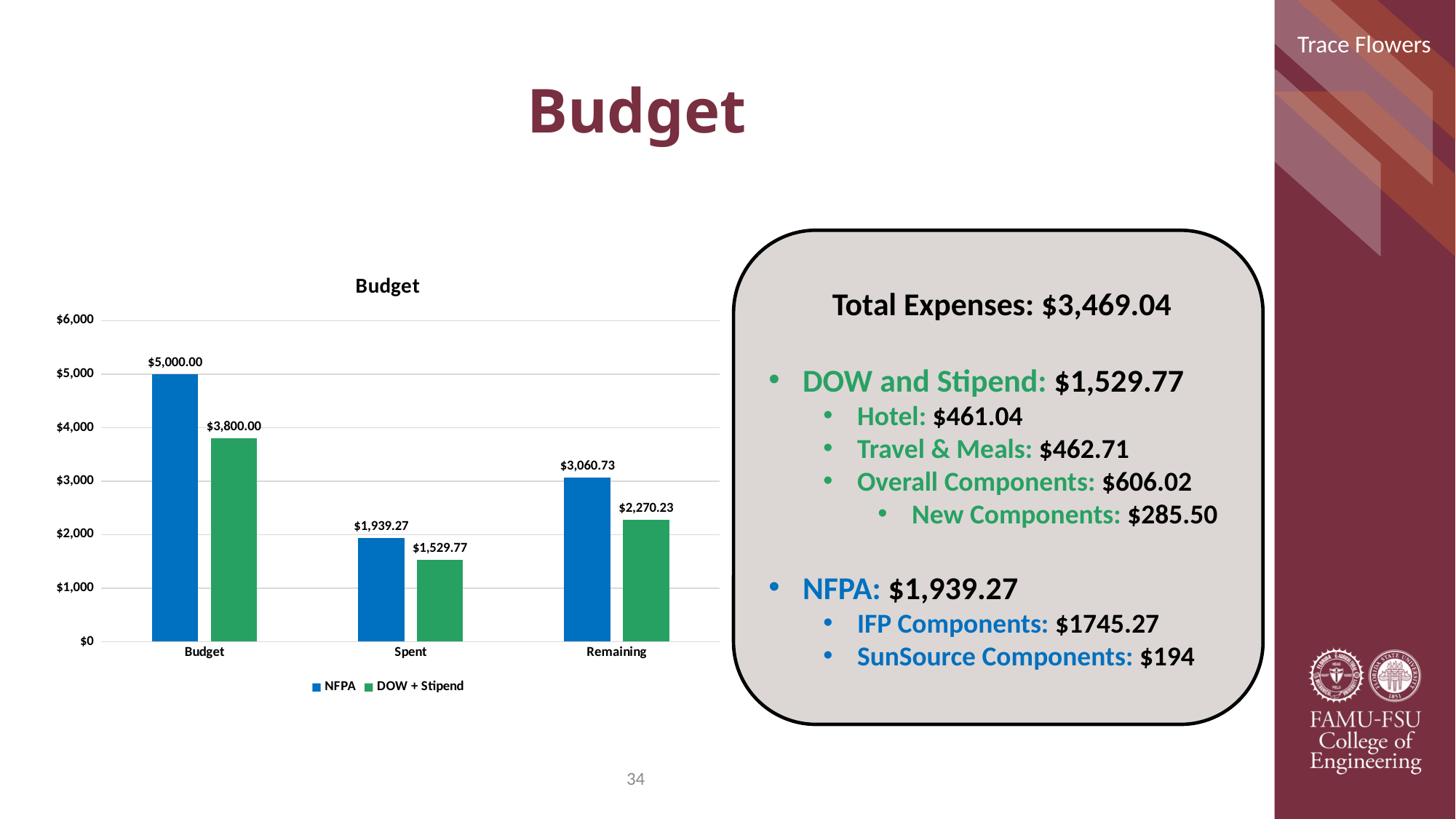
What is the NFPA value for the Remaining category? $3,060.73 Which category has the lowest DOW + Stipend value? Spent What is the DOW + Stipend value for the Spent category? $1,529.77 What is the difference between the NFPA and DOW + Stipend values for the Spent category? $409.50 How many series does the legend list? 2 What is the NFPA value for the Budget category? $5,000.00 What is the DOW + Stipend value for the Budget category? $3,800.00 What kind of chart is shown? Bar chart Which category has the highest NFPA value? Budget How many categories are shown on the x axis? 3 Which is larger for the Remaining category, NFPA or DOW + Stipend? NFPA What is the title of the chart? Budget